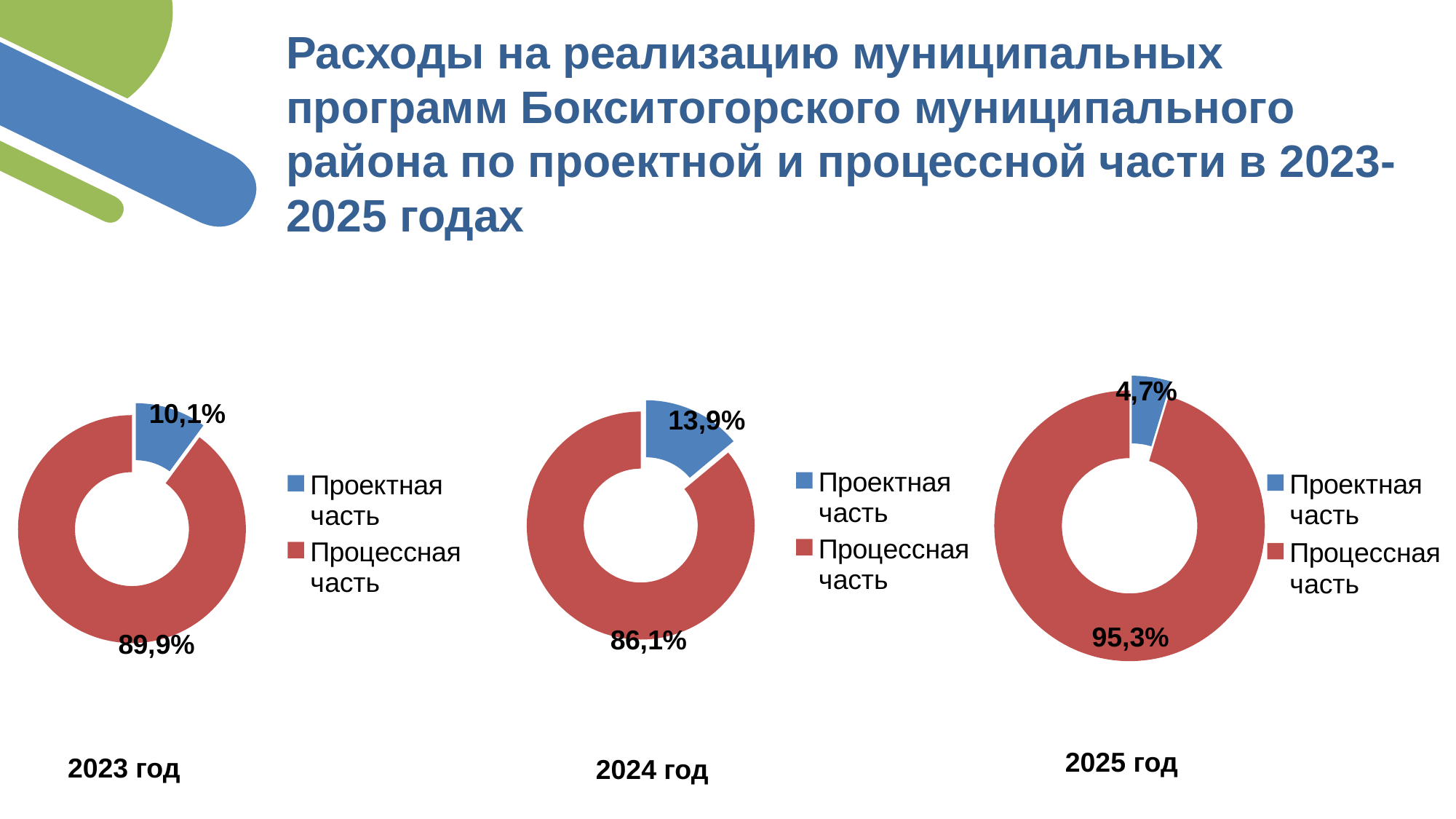
In the 2025 год chart, what is the value for Проектная часть? 4,7% In the 2025 год chart, what is the value for Процессная часть? 95,3% In the 2023 год chart, what is the difference between Процессная часть and Проектная часть? 79,8% In the 2024 год chart, what is the value for Процессная часть? 86,1% In the 2024 год chart, what is the value for Проектная часть? 13,9% In the 2023 год chart, what is the value for Процессная часть? 89,9% What type of chart is used for the 2023 год chart? Doughnut (pie) chart In the 2024 год chart, which category has the smallest share? Проектная часть Which is larger: Проектная часть in the 2024 год chart or Проектная часть in the 2025 год chart? 2024 год In the 2025 год chart, which category has the largest share? Процессная часть In the 2023 год chart, what is the value for Проектная часть? 10,1% How many series does the legend of the 2024 год chart list? 2